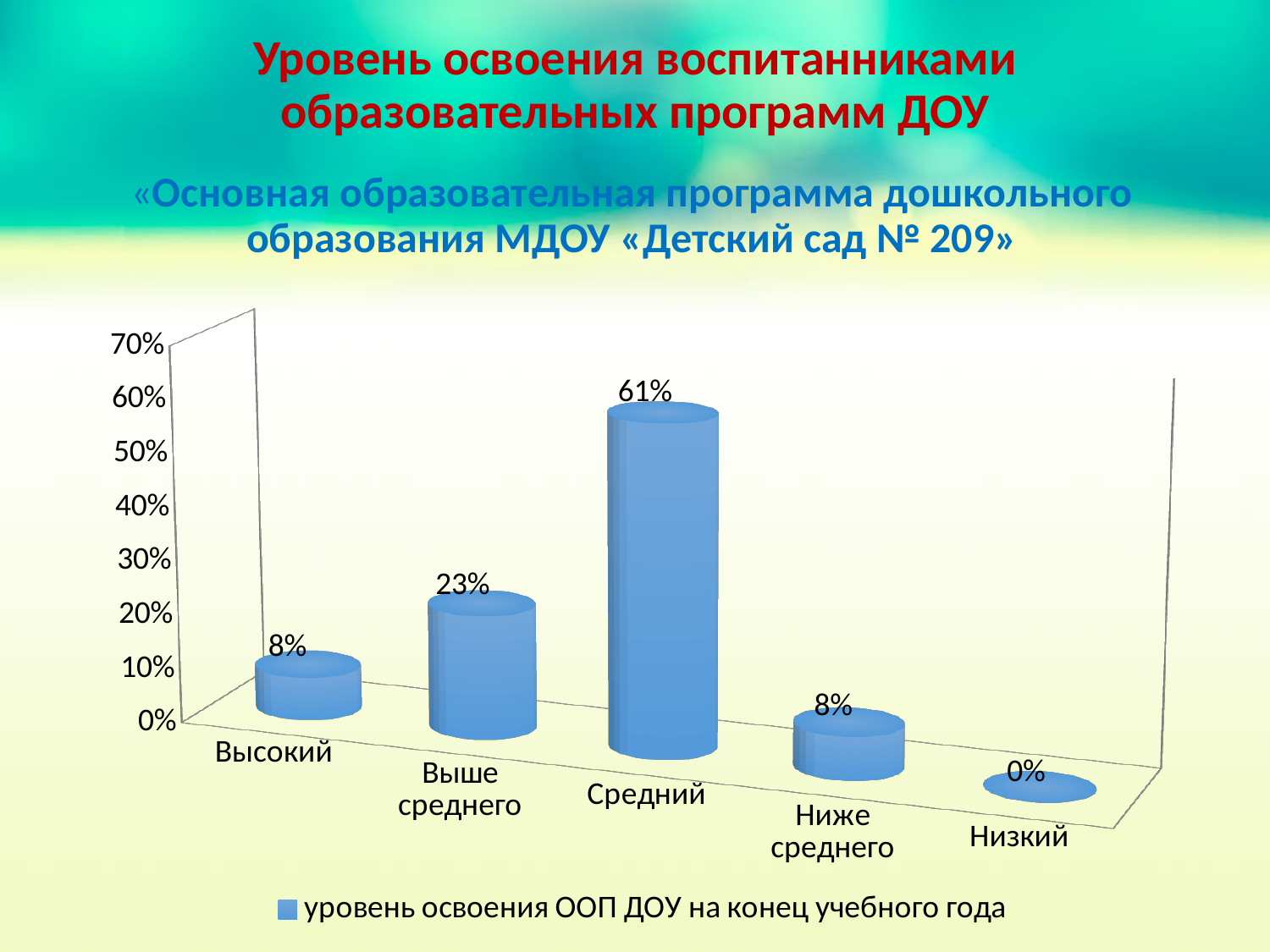
What is the value for Низкий? 0% Which category has the highest value? Средний Which is larger, the value for Выше среднего or the value for Ниже среднего? Выше среднего How many categories are shown on the x axis? 5 What kind of chart is shown on the slide? Bar chart Which category has the lowest value? Низкий What is the legend entry for the series? уровень освоения ООП ДОУ на конец учебного года What is the difference between the values for Средний and Выше среднего? 38% What is the value for Высокий? 8% What is the value for Средний? 61% What is the value for Выше среднего? 23% How many series does the legend list? 1